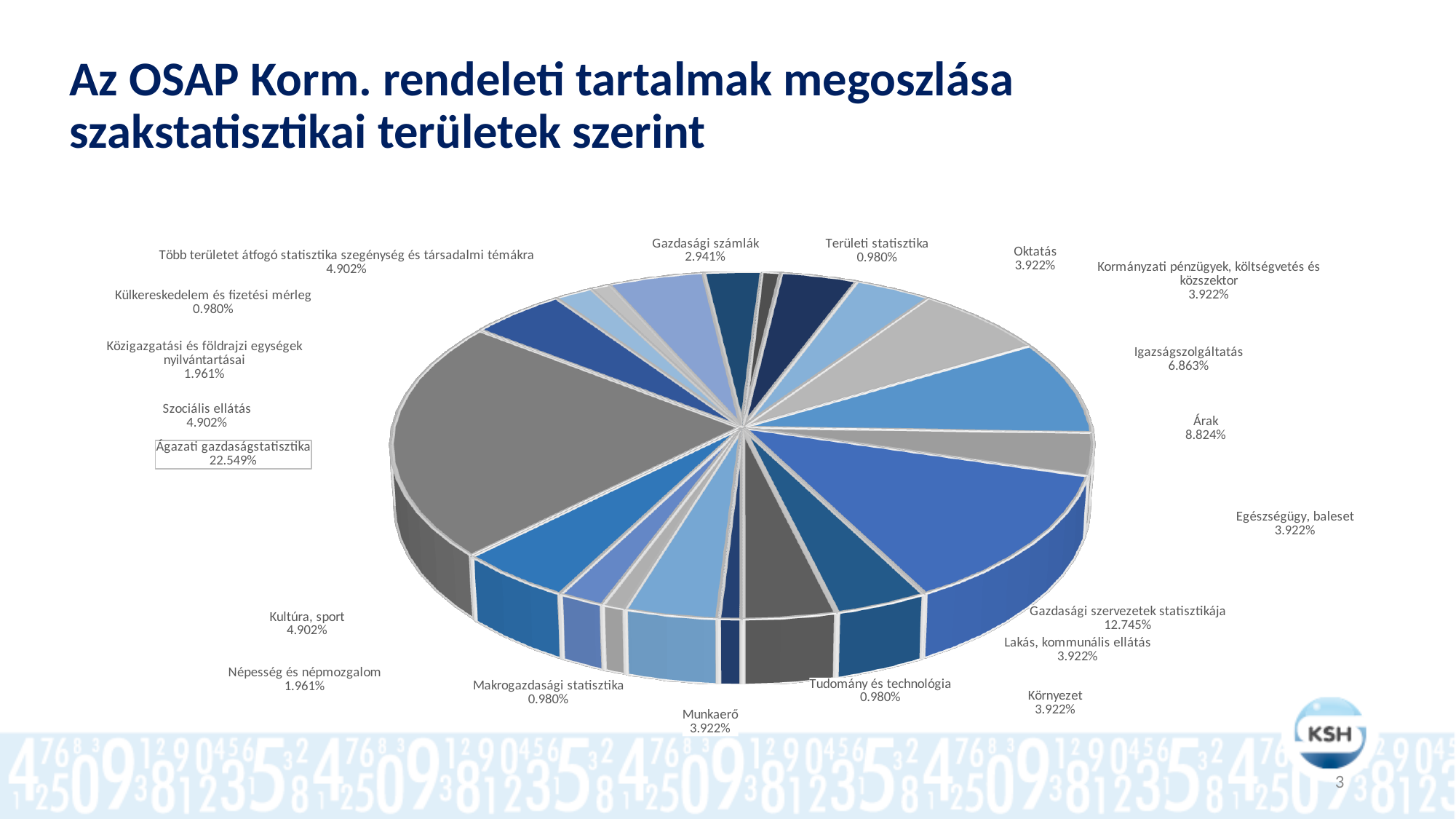
What percentage is shown for Igazságszolgáltatás? 6.863% Which is larger, the share for Árak or the share for Igazságszolgáltatás? Árak What percentage is shown for Gazdasági számlák? 2.941% What is the difference between the shares of Ágazati gazdaságstatisztika and Gazdasági szervezetek statisztikája? 9.804% What percentage is shown for Árak? 8.824% What is the title of the slide containing the pie chart? Az OSAP Korm. rendeleti tartalmak megoszlása szakstatisztikai területek szerint What share of the pie does Ágazati gazdaságstatisztika have? 22.549% How many categories (slices) does the pie chart have? 20 What kind of chart is shown on the slide? pie chart What percentage is shown for Népesség és népmozgalom? 1.961% What percentage is shown for Gazdasági szervezetek statisztikája? 12.745% Which category has the largest share of the pie? Ágazati gazdaságstatisztika